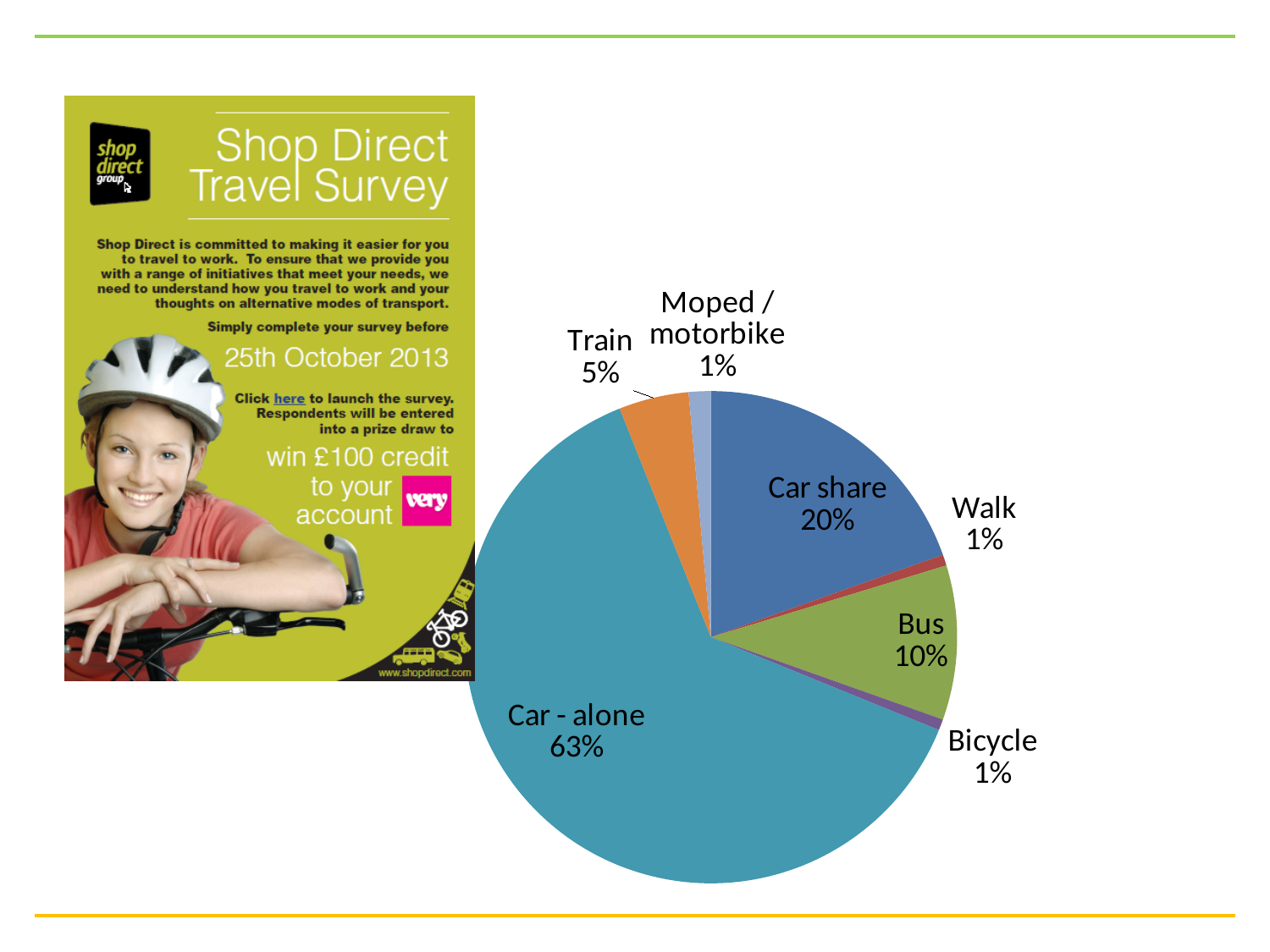
What kind of chart is shown on the slide? Pie chart What is the value for Train? 5% What is the value for Moped / motorbike? 1% Which category has the largest slice of the pie? Car - alone What is the value for Bus? 10% What share of the pie does Car - alone represent? 63% What is the difference between the Car - alone and Car share values? 43% Which is larger, Bus or Train? Bus How many categories are shown in the pie chart? 7 What is the value for Car share? 20% What is the combined value of Walk and Bicycle? 2% What is the difference between the Car share and Bus values? 10%